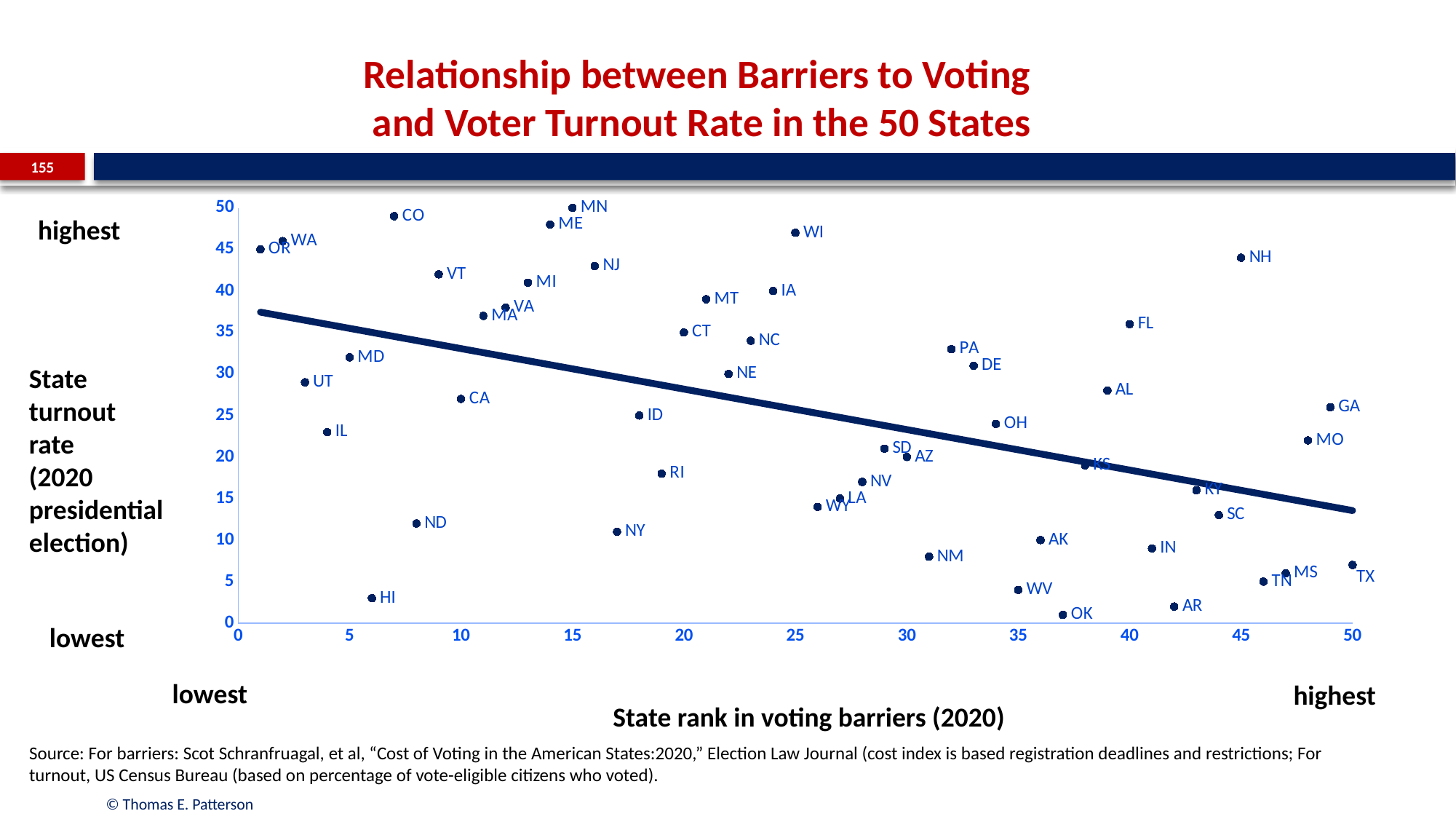
Is the turnout rate for TX greater or less than 10? less Is the turnout rate for WI greater or less than 45? greater Is the turnout rate for IL greater or less than 25? less As the state rank in voting barriers increases along the x axis, does the trend line for state turnout rate rise or fall? fall What is the title of the x axis? State rank in voting barriers (2020) Which state has the higher turnout rate, HI or CO? CO Which state has the lowest turnout rate on the chart? OK What kind of chart is shown on the slide? scatter plot Which state has the higher turnout rate, OR or UT? OR